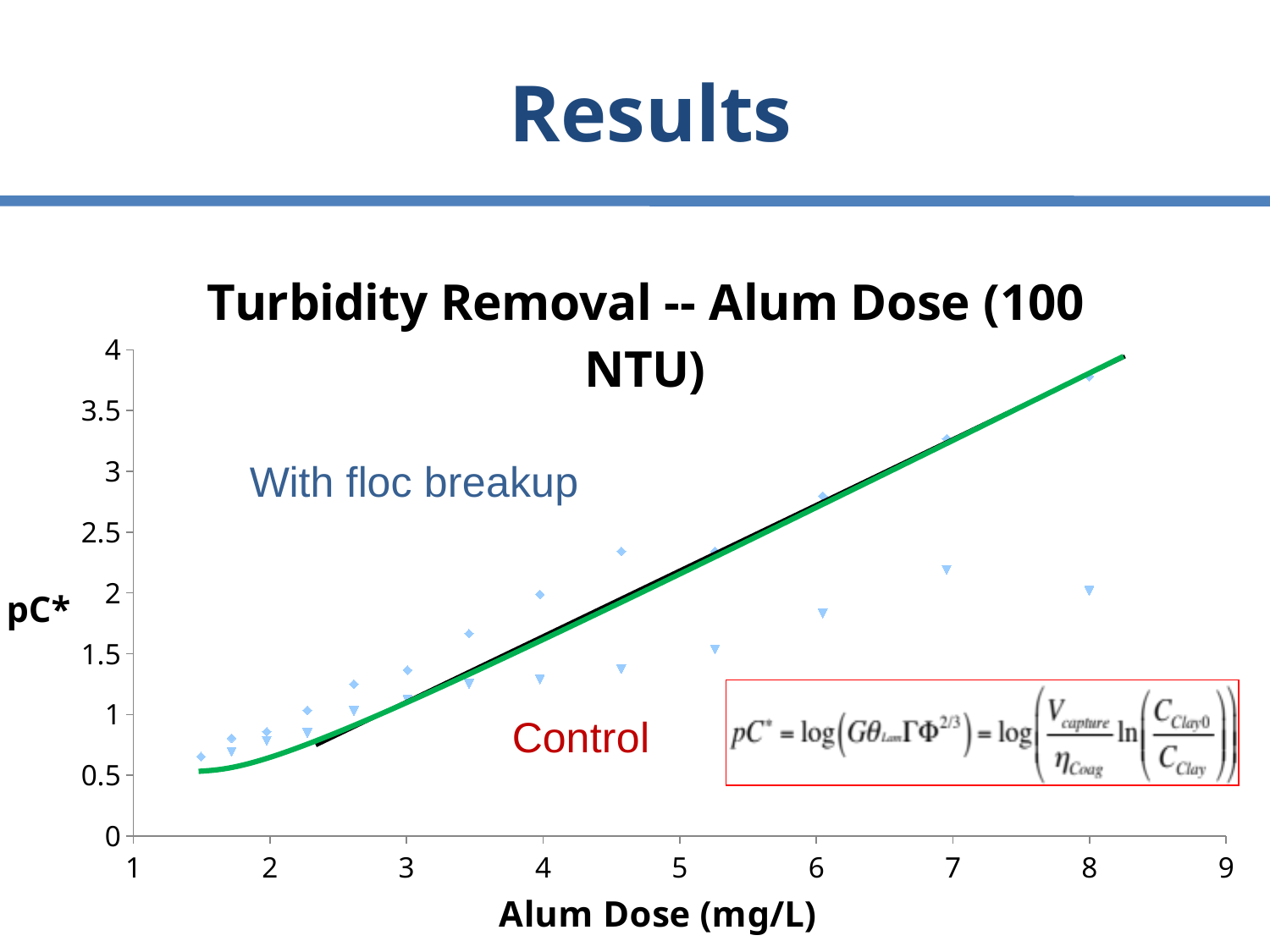
At an alum dose of 8 mg/L, which series has the higher pC* value, 'With floc breakup' or 'Control'? With floc breakup Is the 'With floc breakup' value at an alum dose of 8 mg/L greater or less than 3.5? greater What kind of chart is shown on the slide? Scatter chart Is the 'Control' value at an alum dose of 5.25 mg/L greater or less than 2? less Do the 'With floc breakup' values rise or fall as alum dose increases? Rise At an alum dose of 6 mg/L, which series has the higher pC* value, 'With floc breakup' or 'Control'? With floc breakup Is the 'With floc breakup' value at an alum dose of 7 mg/L greater or less than 3? greater How many data series are plotted on the chart? 2 What is the label of the x axis? Alum Dose (mg/L) What is the title of the chart? Turbidity Removal -- Alum Dose (100 NTU) What is the maximum value shown on the y axis? 4